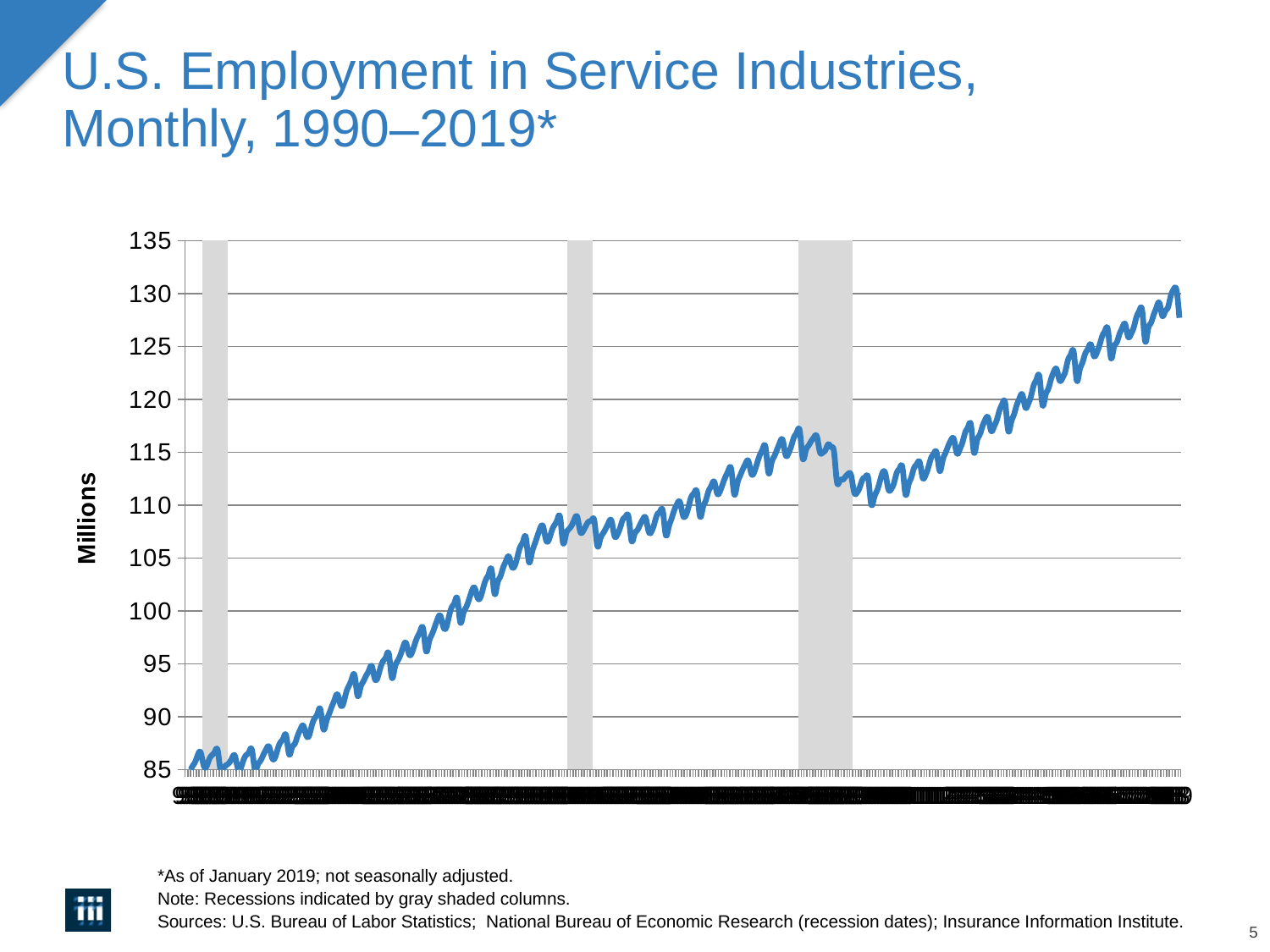
What is the label on the vertical axis? Millions What is the title of the chart? U.S. Employment in Service Industries, Monthly, 1990–2019* Does the series reach its lowest value near the beginning or near the end of the period? near the beginning Is the value at the end of the series (January 2019) greater or less than 125? greater How many gray shaded recession columns are shown on the chart? 3 Overall, do the values rise or fall from left to right along the x axis? rise What is the highest value shown on the vertical axis? 135 Is the value at the end of the series (January 2019) greater or less than 135? less Does the series reach its highest value near the beginning or near the end of the period? near the end Is the value at the start of the series (1990) greater or less than 90? less What kind of chart is shown on the slide? line chart